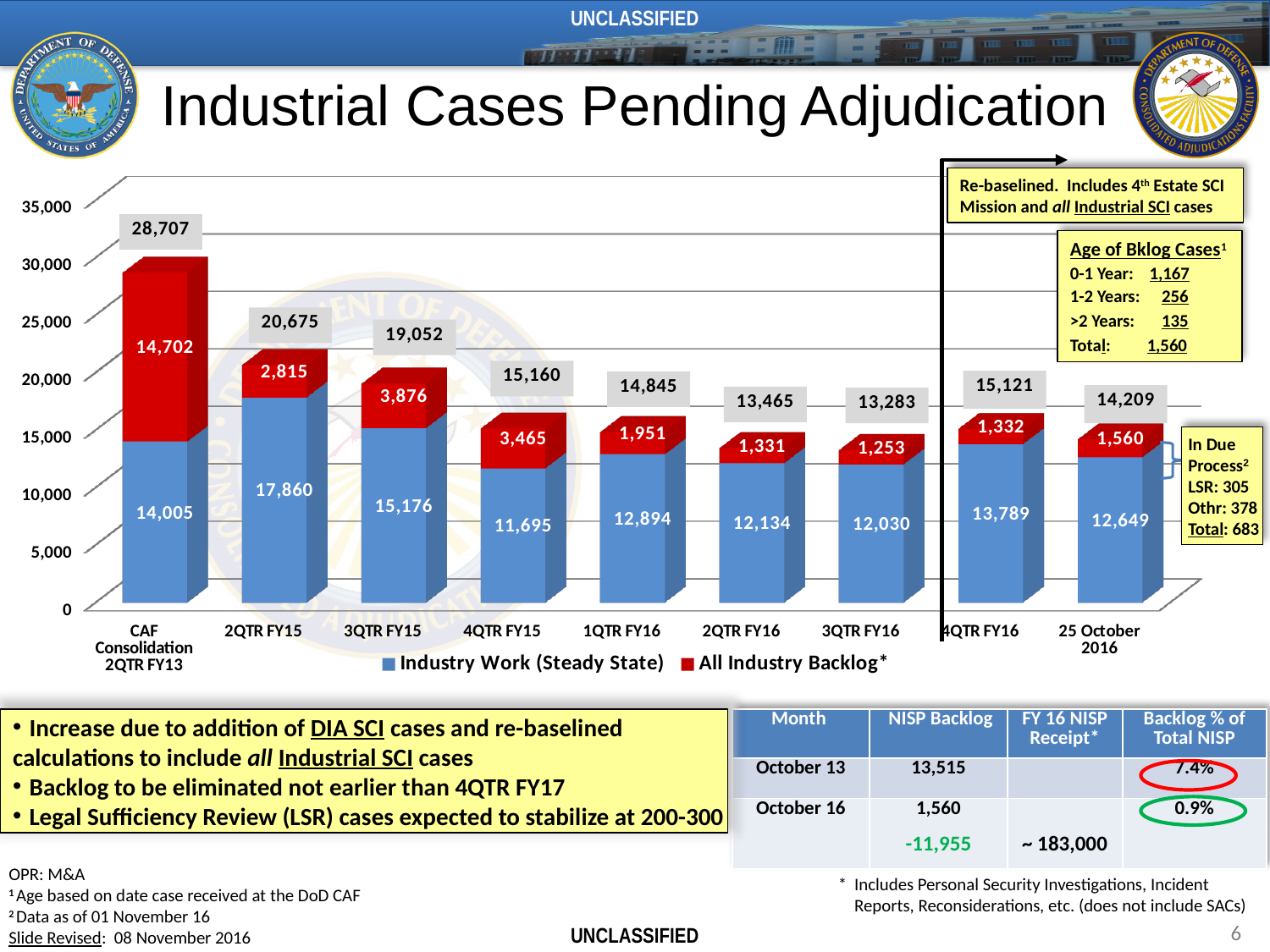
Which category has the highest All Industry Backlog* value? CAF Consolidation 2QTR FY13 Which colour represents All Industry Backlog* in the chart? Red Which is larger, the All Industry Backlog* value for 2QTR FY16 or for 3QTR FY16? 2QTR FY16 Which category has the lowest Industry Work (Steady State) value? 4QTR FY15 What is the Industry Work (Steady State) value for 2QTR FY15? 17,860 What is the total labeled above the bar for 25 October 2016? 14,209 What is the difference between the Industry Work (Steady State) values for 4QTR FY16 and 3QTR FY16? 1,759 How many categories are shown on the x axis of the chart? 9 Is the total for 3QTR FY15 greater or less than 20,000? less What kind of chart is shown on the slide? Stacked bar chart How many series does the chart legend list? 2 What is the All Industry Backlog* value for 4QTR FY15? 3,465